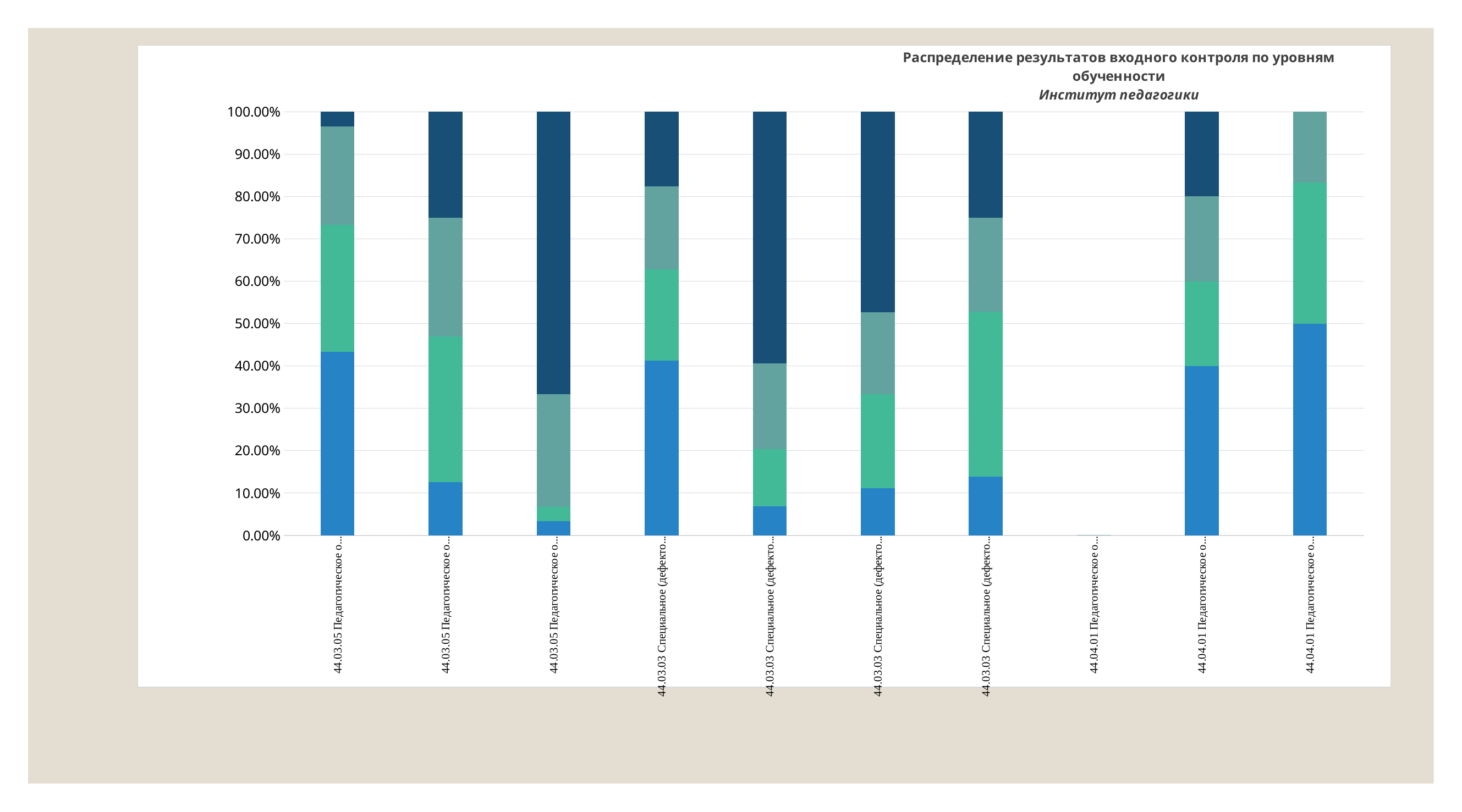
Is the bottom (blue) segment of the first bar from the left greater or less than 40.00%? greater Is the bottom (blue) segment of the fourth bar from the left greater or less than 30.00%? greater Which bar has the larger bottom (blue) segment: the first bar from the left or the third bar from the left? the first bar from the left How many category labels are shown along the x axis of the chart? 10 Is the bottom (blue) segment of the second bar from the left greater or less than 20.00%? less What is the title of the chart? Распределение результатов входного контроля по уровням обученности Институт педагогики What is the total height of the first (leftmost) stacked bar? 100.00% What kind of chart is shown on the slide? stacked bar chart How many differently coloured segments are stacked in the bars of the chart? 4 Does the rightmost bar contain a dark navy (top) segment? No